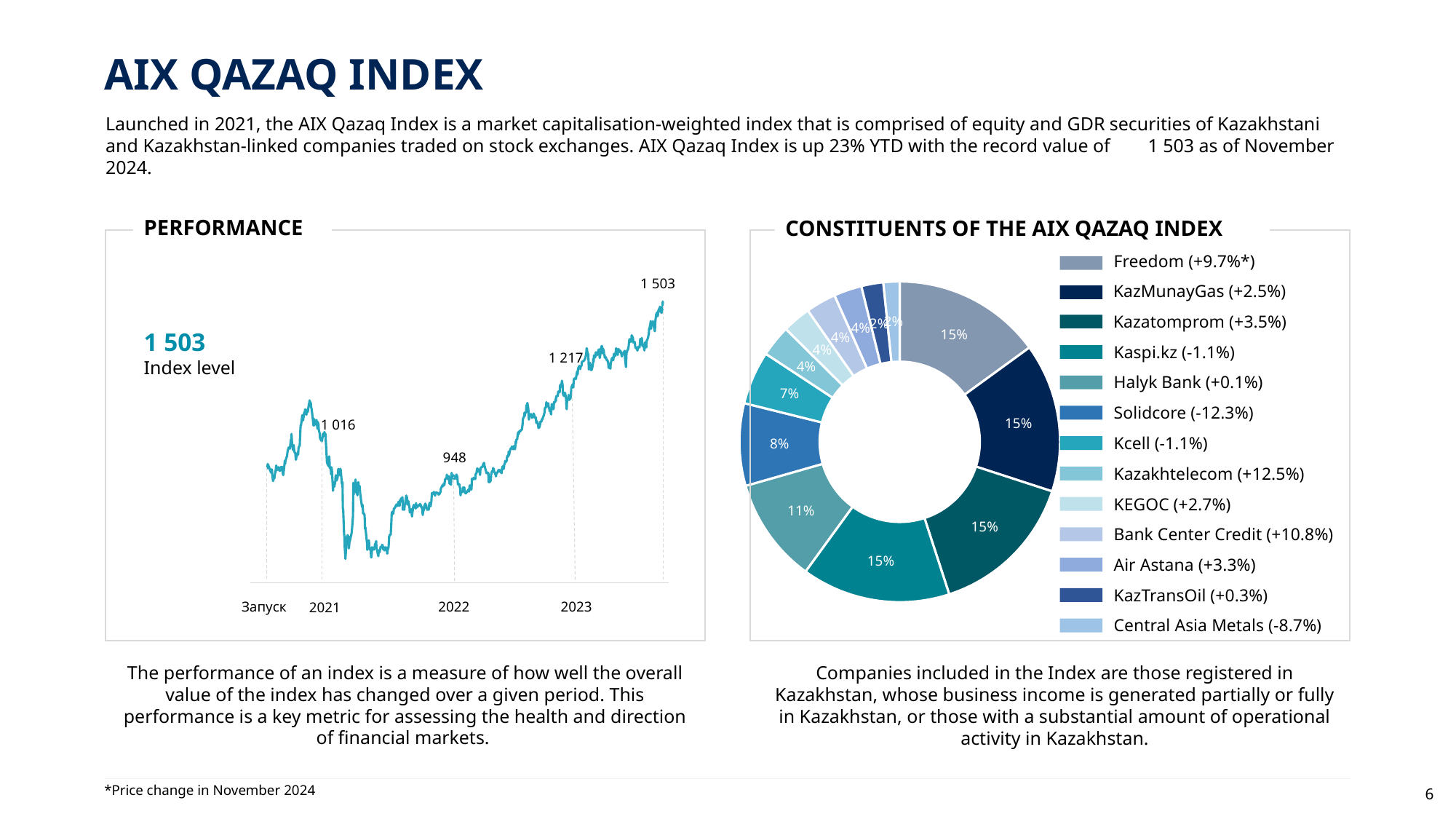
On the PERFORMANCE chart, what is the difference between the final value of 1 503 and the 2023 value of 1 217? 286 On the PERFORMANCE chart, does the index rise or fall between the 2022 and 2023 markers? Rise On the PERFORMANCE chart, what index value is labelled near the 2021 marker? 1 016 What kind of chart is the PERFORMANCE chart? Line chart On the CONSTITUENTS OF THE AIX QAZAQ INDEX chart, what share does Halyk Bank have? 11% On the CONSTITUENTS OF THE AIX QAZAQ INDEX chart, which has the larger share, Halyk Bank or Kcell? Halyk Bank On the PERFORMANCE chart, what index value is labelled at the 2023 marker? 1 217 What kind of chart is the CONSTITUENTS OF THE AIX QAZAQ INDEX chart? Doughnut (pie) chart On the PERFORMANCE chart, what is the index level labelled at the end of the line? 1 503 On the CONSTITUENTS OF THE AIX QAZAQ INDEX chart, what share does Solidcore have? 8% On the PERFORMANCE chart, what index value is labelled at the 2022 marker? 948 How many constituents are listed in the legend of the CONSTITUENTS OF THE AIX QAZAQ INDEX chart? 13